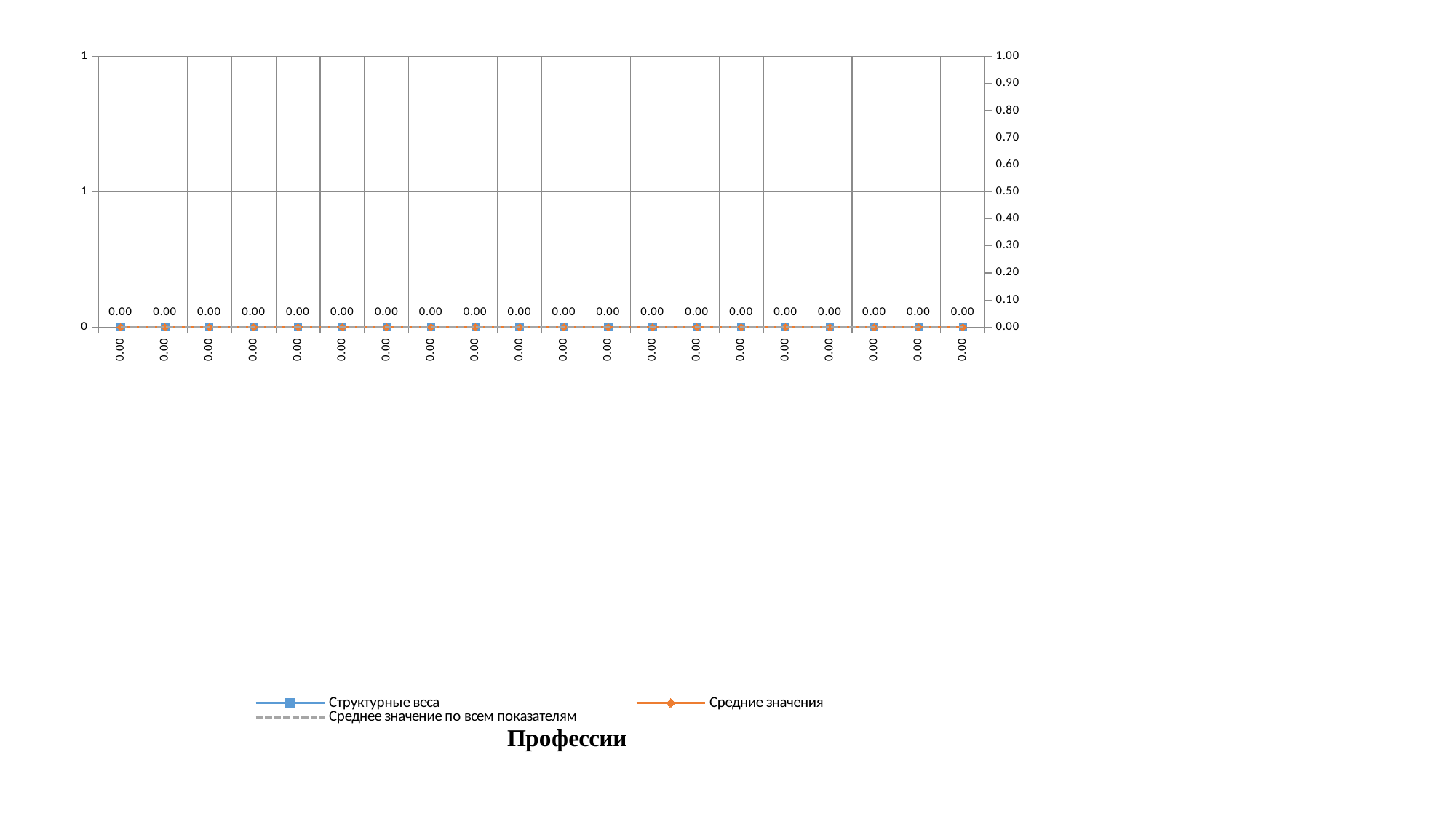
What kind of chart is shown on the slide? line chart Is the value of the plotted points greater or less than 0.50 on the right-hand axis? less Do the plotted values rise, fall, or stay flat along the x axis? stay flat What is the highest tick value shown on the right-hand vertical axis? 1.00 How many series does the legend list? 3 What value is shown by the data labels above the points? 0.00 How many data points are plotted along the x axis? 20 What is the name of the first series listed in the legend? Структурные веса